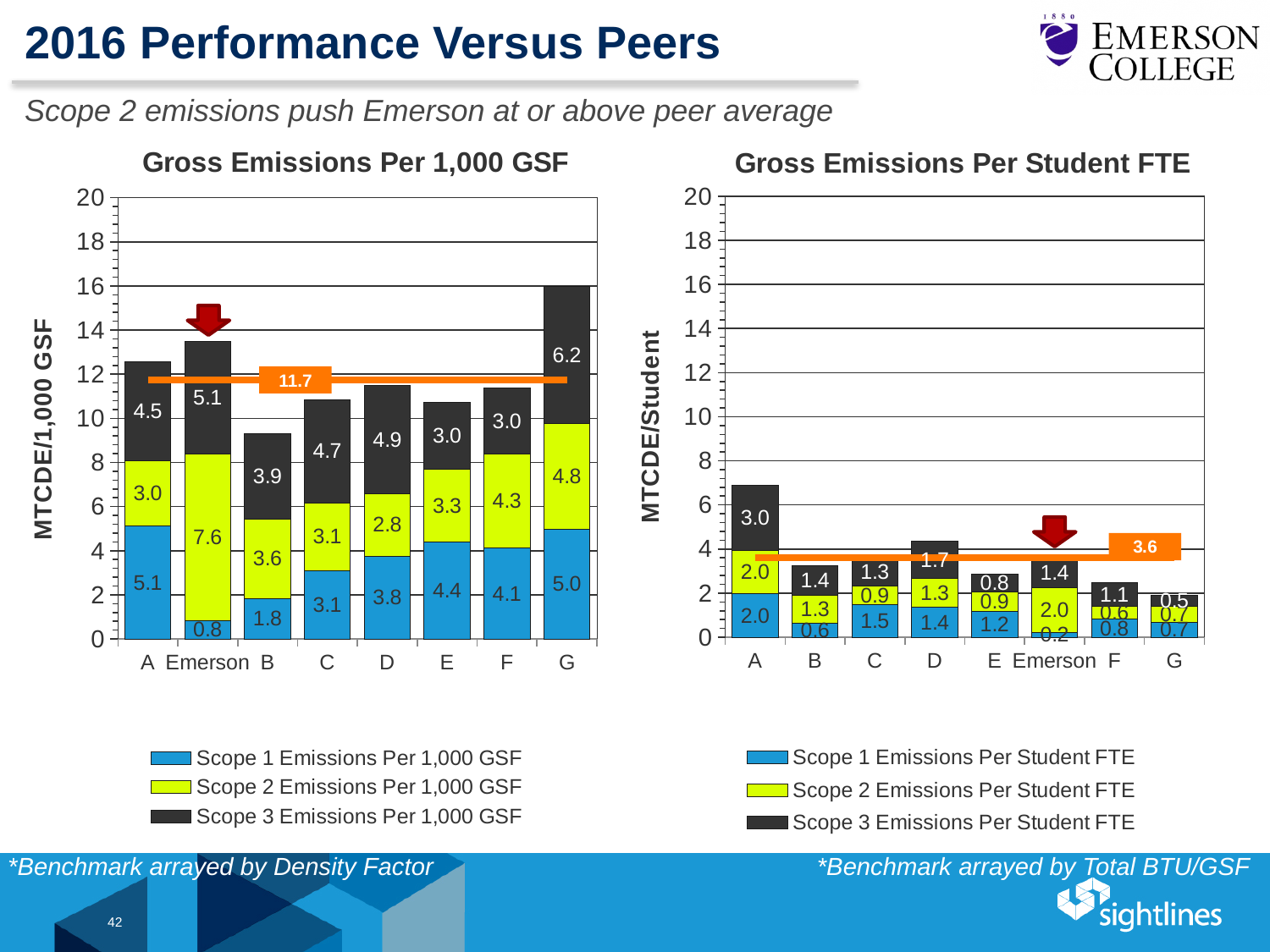
In the Gross Emissions Per 1,000 GSF chart, what is the total of the stacked bar for A? 12.6 In the Gross Emissions Per Student FTE chart, is the stacked bar for A greater or less than 6? greater In the Gross Emissions Per 1,000 GSF chart, what is the difference between the Scope 1 values for A and Emerson? 4.3 In the Gross Emissions Per Student FTE chart, what is the Scope 3 Emissions Per Student FTE value for A? 3.0 In the Gross Emissions Per 1,000 GSF chart, what is the Scope 3 Emissions Per 1,000 GSF value for G? 6.2 In the Gross Emissions Per 1,000 GSF chart, what is the Scope 2 Emissions Per 1,000 GSF value for Emerson? 7.6 What kind of chart is the Gross Emissions Per 1,000 GSF chart? Stacked bar chart In the Gross Emissions Per 1,000 GSF chart, what benchmark value is shown on the orange line? 11.7 In the Gross Emissions Per 1,000 GSF chart, which category has the tallest stacked bar? G How many series does the legend of the Gross Emissions Per Student FTE chart list? 3 In the Gross Emissions Per 1,000 GSF chart, which category has the shortest stacked bar? B In the Gross Emissions Per Student FTE chart, which category has the tallest stacked bar? A